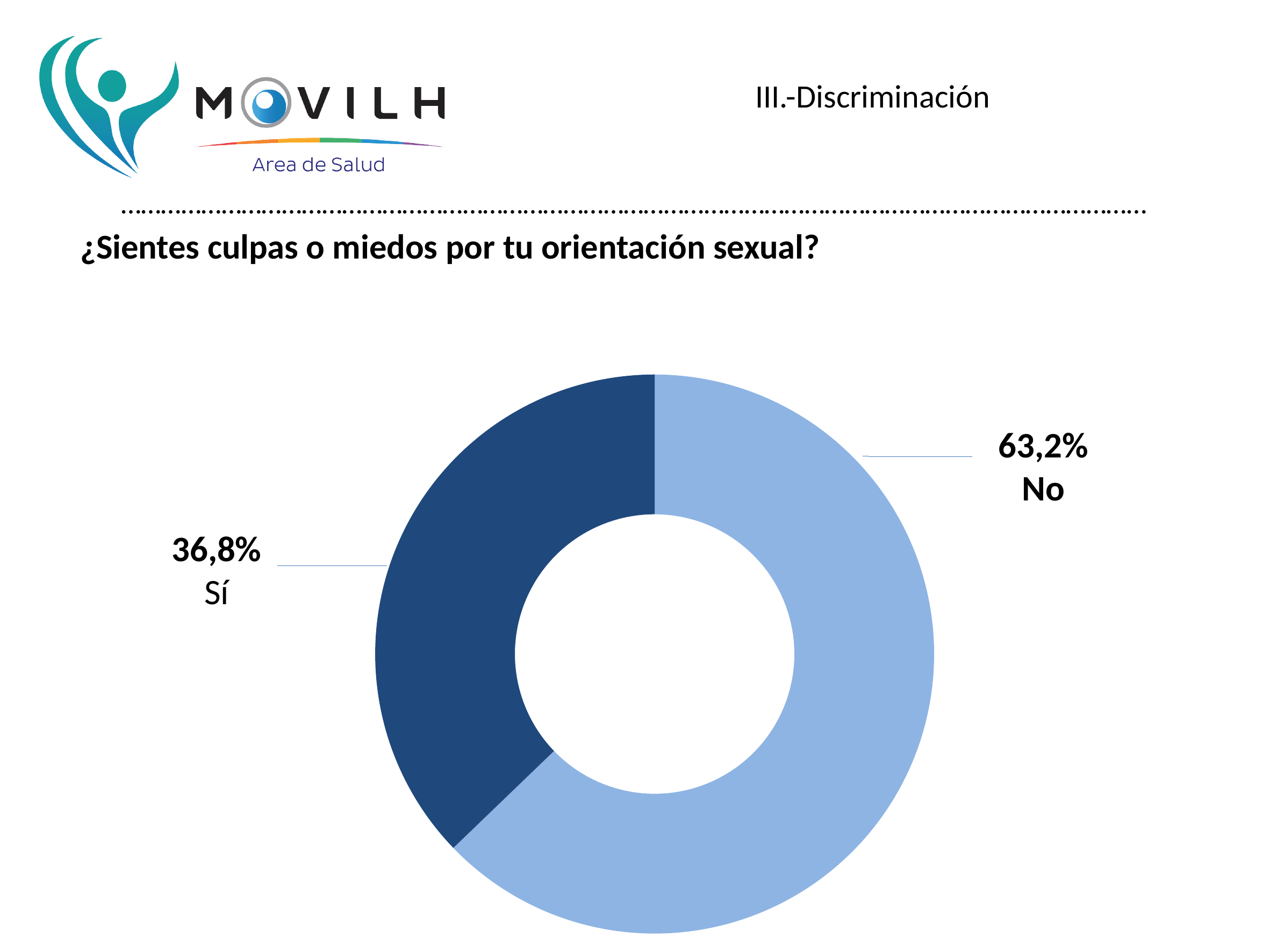
What kind of chart is shown on the slide? Doughnut chart What percentage of respondents answered "No"? 63,2% What is the share of the chart taken by the "No" slice? 63,2% What is the difference in percentage points between the "No" and "Sí" responses? 26,4 Which is larger, the share for "Sí" or the share for "No"? No Which response has the largest share of the chart? No Which response is shown in the darker blue colour? Sí How many categories are shown in the chart? 2 Which response has the smallest share of the chart? Sí What percentage of respondents answered "Sí"? 36,8% What question does the chart on the slide answer? ¿Sientes culpas o miedos por tu orientación sexual?